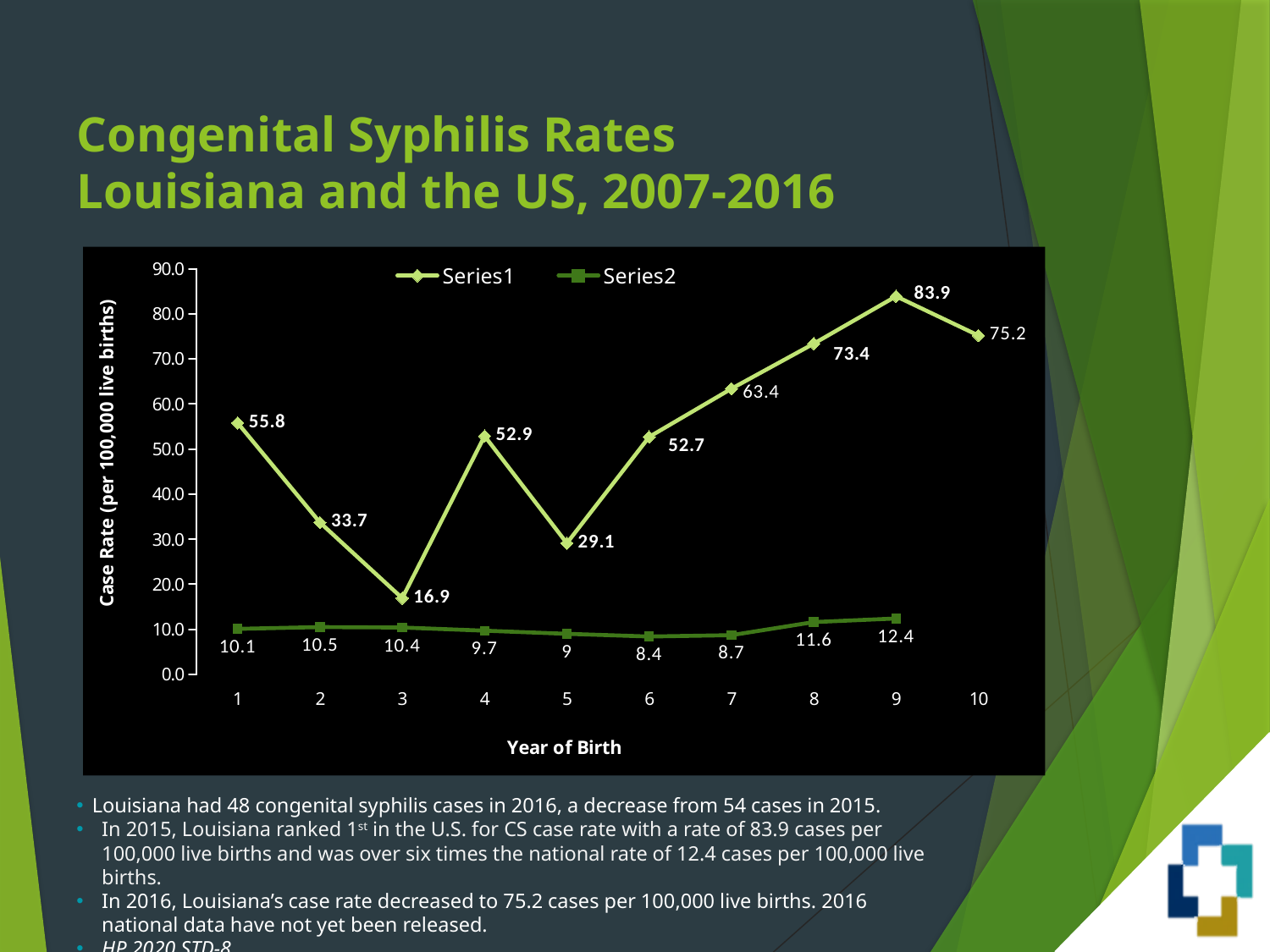
Which is larger: the Series1 value at year 4 or at year 6? year 4 What is the value of Series1 at year 9? 83.9 What is the label of the y axis? Case Rate (per 100,000 live births) How many series does the legend list? 2 What type of chart is shown on the slide? line chart What is the difference between Series1 and Series2 at year 9? 71.5 What is the value of Series1 at year 3? 16.9 At which year does Series1 have its lowest value? 3 What is the value of Series2 at year 4? 9.7 How many data points are plotted for Series2? 9 What is the difference between the Series1 values at year 9 and year 10? 8.7 At which year does Series1 reach its highest value? 9